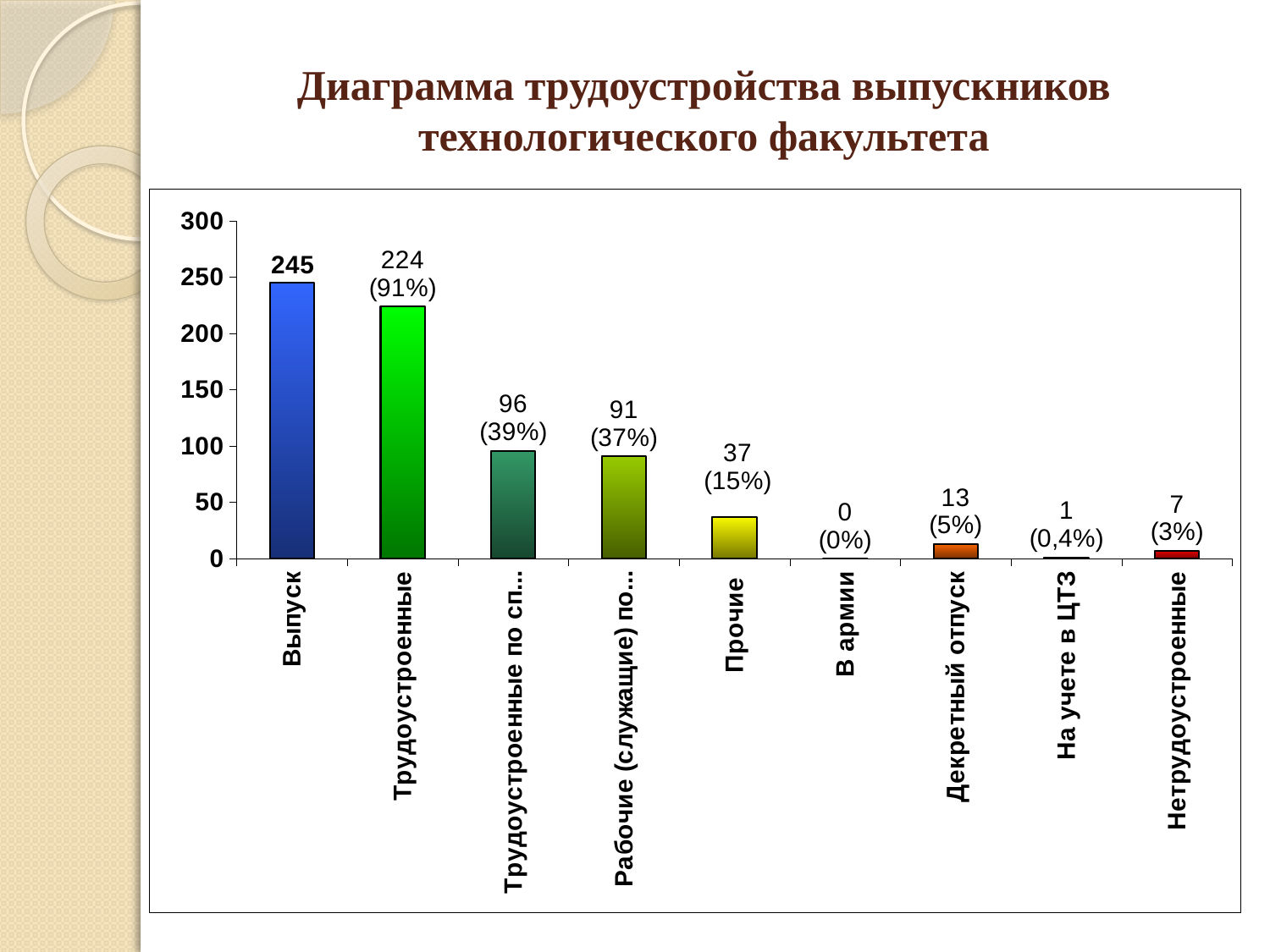
Which is larger, the value for Нетрудоустроенные or the value for Декретный отпуск? Декретный отпуск Which category has the highest value? Выпуск What is the title of the slide? Диаграмма трудоустройства выпускников технологического факультета How many categories are shown on the x axis? 9 What is the value for Трудоустроенные? 224 What is the value for Выпуск? 245 What is the value for Декретный отпуск? 13 What kind of chart is shown on the slide? bar chart What percentage is shown for На учете в ЦТЗ? 0,4% What percentage is shown for Прочие? 15% Which category has the lowest value? В армии What is the difference between the values for Выпуск and Трудоустроенные? 21